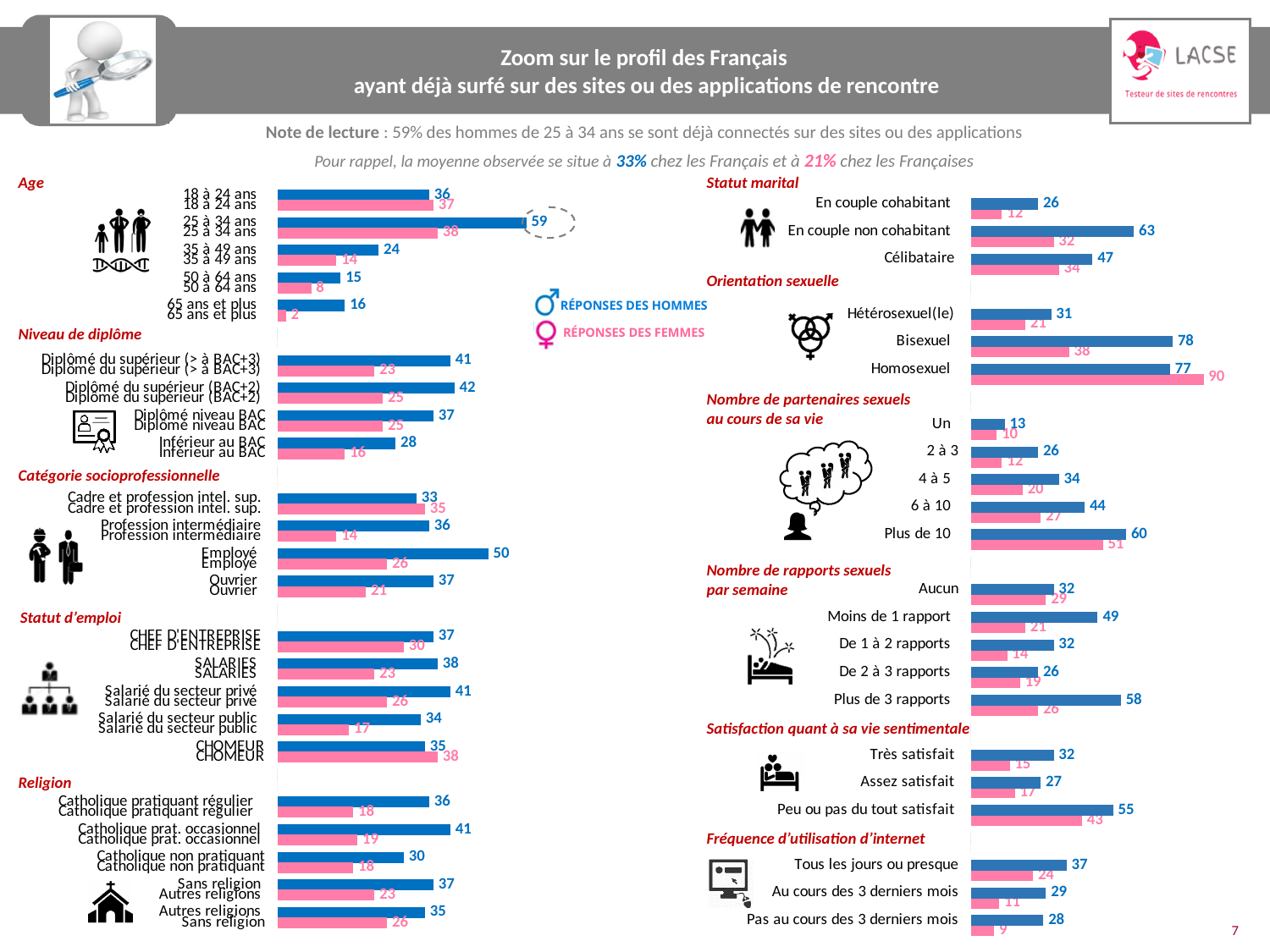
In the 'Fréquence d'utilisation d'internet' chart, which category has the lowest value for women (réponses des femmes)? Pas au cours des 3 derniers mois In the 'Orientation sexuelle' chart, which category has the highest value for women (réponses des femmes)? Homosexuel In the 'Satisfaction quant à sa vie sentimentale' chart, what is the value for women (réponses des femmes) for 'Peu ou pas du tout satisfait'? 43 In the 'Age' chart, what is the value for women (réponses des femmes) aged 65 ans et plus? 2 Which colour represents 'Réponses des femmes' in the charts on this slide? pink In the 'Catégorie socioprofessionnelle' chart, which is larger for 'Cadre et profession intel. sup.': the men's value or the women's value? the women's value How many series does the legend list for the charts on this slide? 2 What kind of chart is used in the 'Religion' section? bar chart How many categories are shown in the 'Nombre de partenaires sexuels au cours de sa vie' chart? 5 In the 'Age' chart, what is the value for men (réponses des hommes) aged 25 à 34 ans? 59 In the 'Statut marital' chart, what is the difference between the men's and women's values for 'En couple non cohabitant'? 31 In the 'Nombre de rapports sexuels par semaine' chart, which category has the highest value for men (réponses des hommes)? Plus de 3 rapports